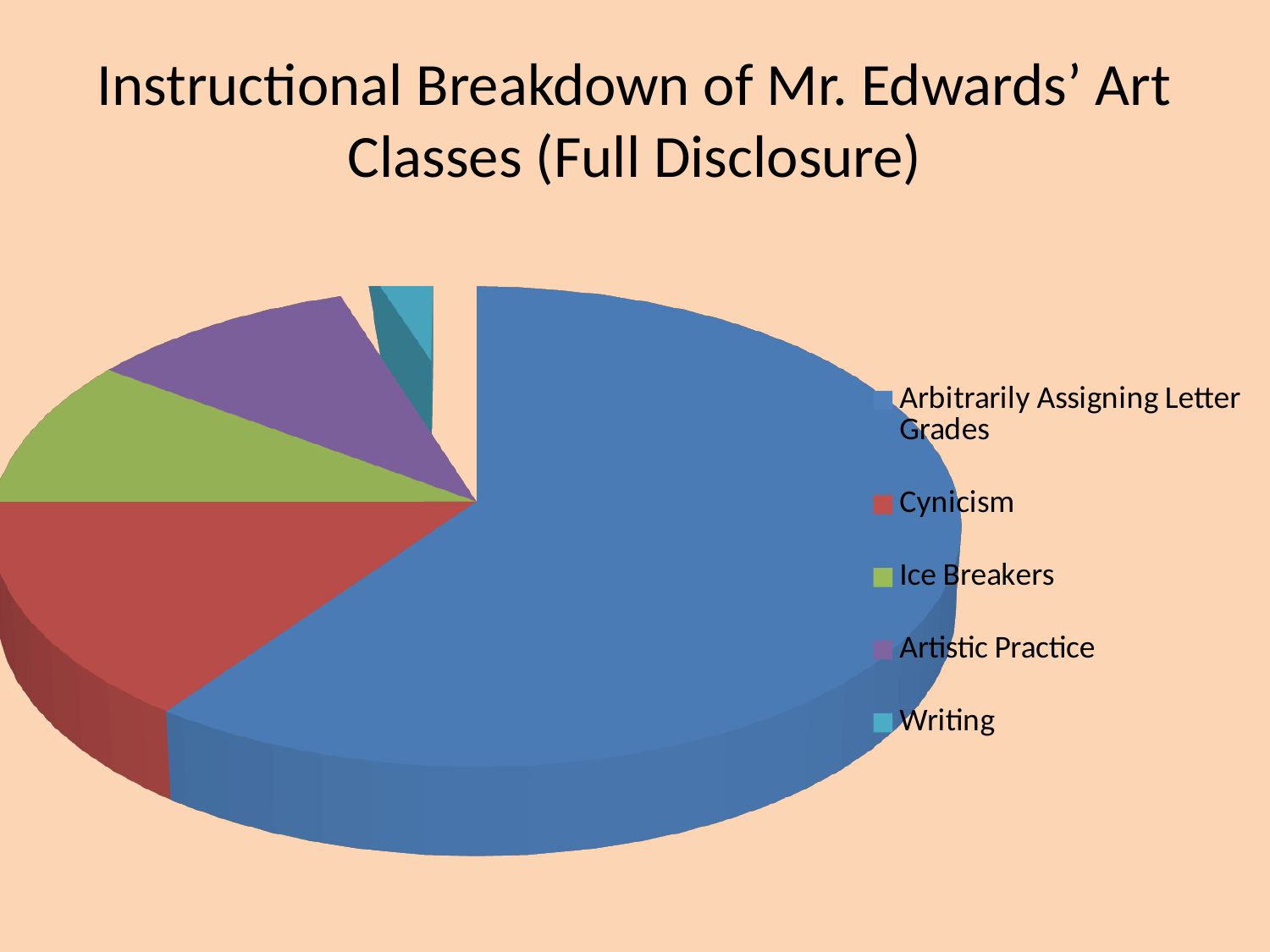
How many entries does the legend of the pie chart list? 5 Which category has the largest slice of the pie chart? Arbitrarily Assigning Letter Grades Which slice is larger, Artistic Practice or Writing? Artistic Practice Which slice is larger, Cynicism or Artistic Practice? Cynicism Which slice is larger, Cynicism or Ice Breakers? Cynicism What kind of chart is shown on the slide? Pie chart What colour is the Cynicism slice in the pie chart? Red Which category has the smallest slice of the pie chart? Writing How many categories (slices) does the pie chart have? 5 What is the title of the slide containing the pie chart? Instructional Breakdown of Mr. Edwards' Art Classes (Full Disclosure) Which category is listed first in the legend of the pie chart? Arbitrarily Assigning Letter Grades